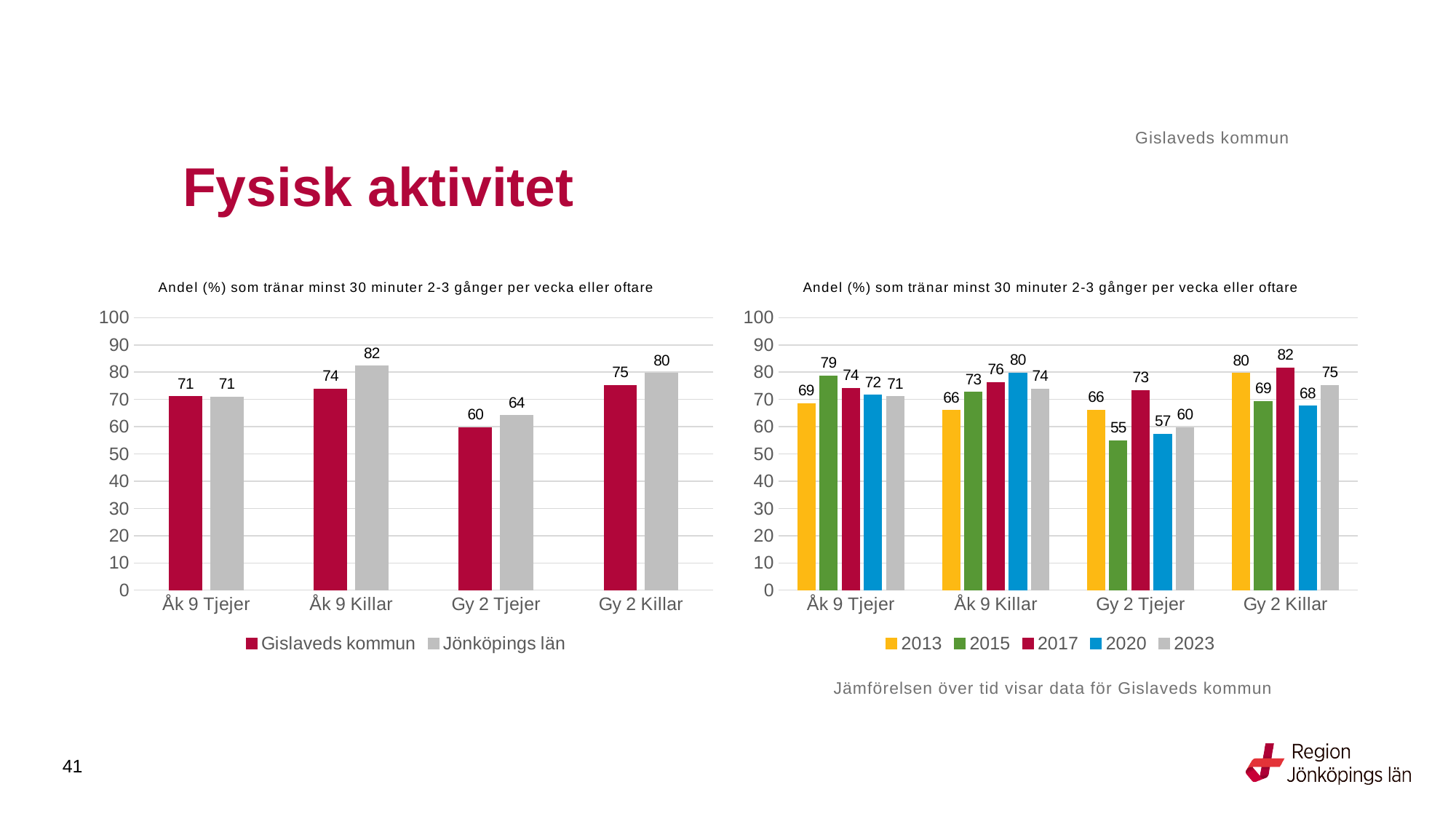
In the left chart, what is the value for Gislaveds kommun for Gy 2 Tjejer? 60 In the left chart, what is the value for Jönköpings län for Åk 9 Killar? 82 In the right chart, is the value for 2013 or 2023 larger for Gy 2 Killar? 2013 In the right chart, what is the difference between the 2017 and 2020 values for Gy 2 Tjejer? 16 What kind of chart is the left chart? Bar chart In the left chart, how many series does the legend list? 2 In the left chart, what is the difference between Jönköpings län and Gislaveds kommun for Åk 9 Killar? 8 In the right chart, what is the value for 2020 for Åk 9 Killar? 80 In the right chart, how many series does the legend list? 5 In the right chart, what is the value for 2015 for Gy 2 Tjejer? 55 In the left chart, which category has the lowest value for Gislaveds kommun? Gy 2 Tjejer In the right chart, which year has the highest value for Gy 2 Killar? 2017